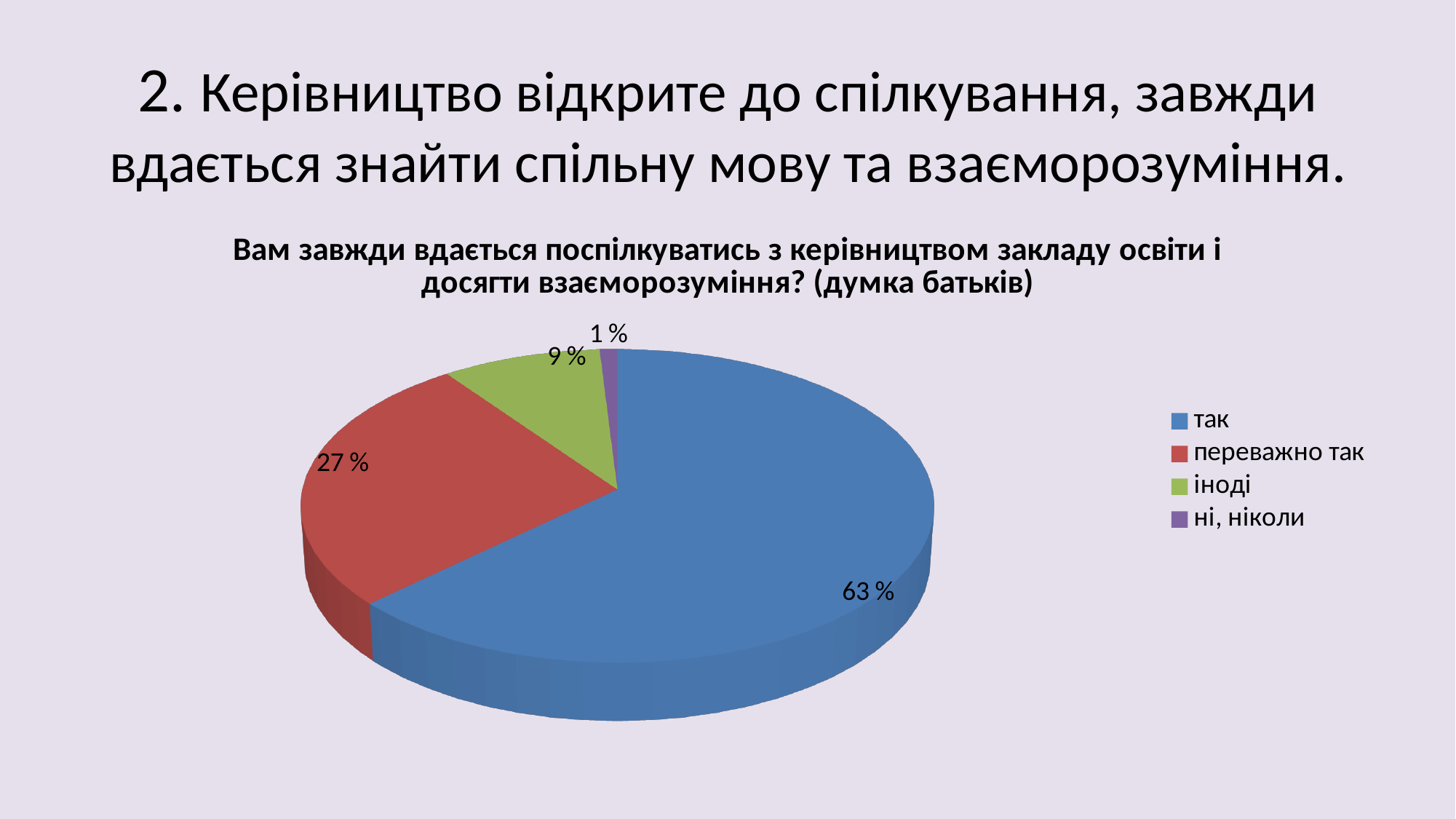
Which category has the smallest slice of the pie? ні, ніколи What is the difference between the values for "переважно так" and "іноді"? 18 % What is the value shown for "ні, ніколи"? 1 % Which is larger, the value for "іноді" or the value for "ні, ніколи"? іноді What is the value shown for "іноді"? 9 % What kind of chart is shown on the slide? pie chart How many categories does the pie chart show? 4 Which category has the largest slice of the pie? так What is the difference between the values for "так" and "переважно так"? 36 % What colour is the "переважно так" slice? red What is the value shown for "переважно так"? 27 % What share of the pie does the "так" slice represent? 63 %